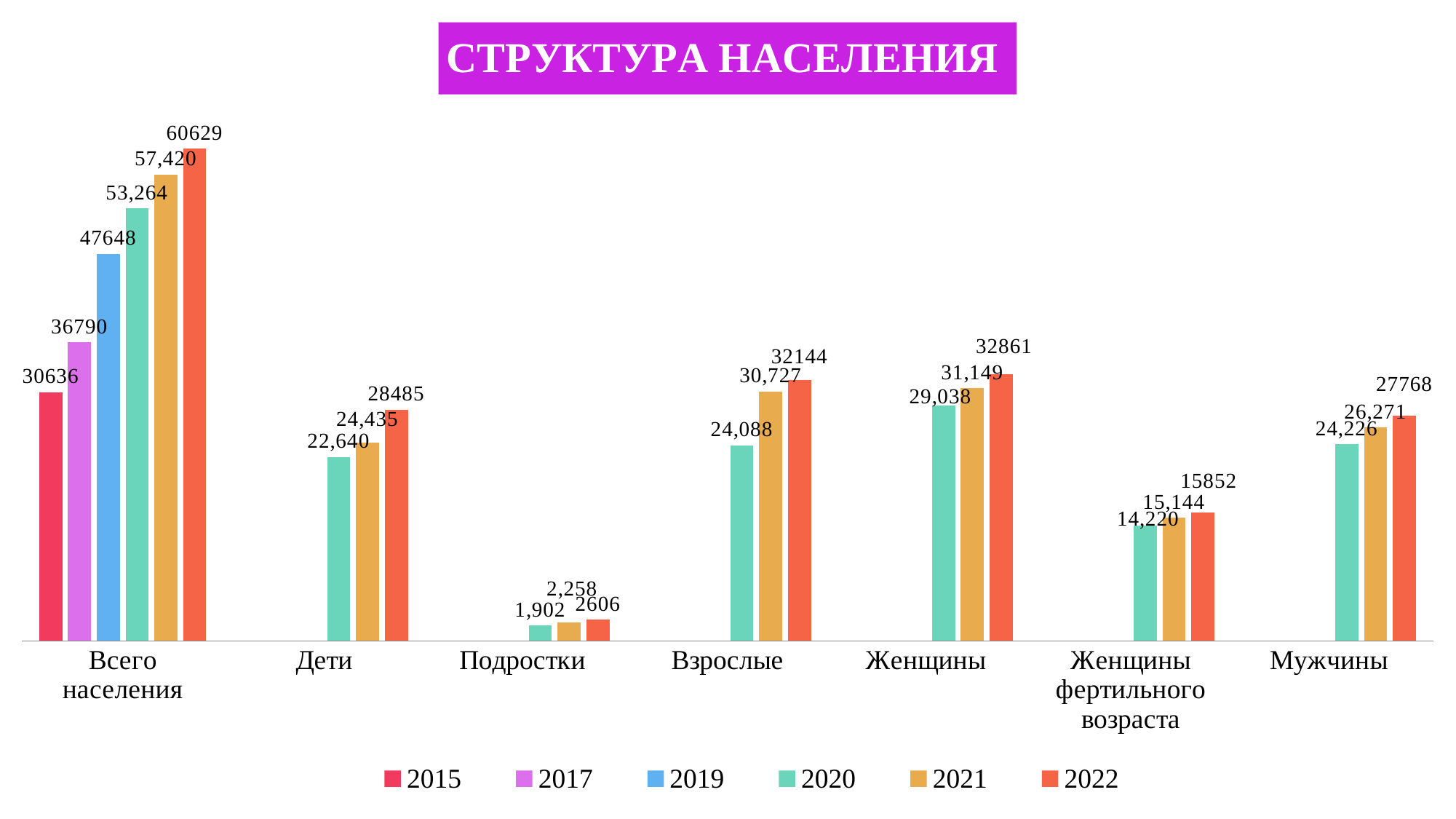
What is the difference between the 2022 and 2015 values for Всего населения? 29993 Which is larger in 2022: Женщины or Мужчины? Женщины What is the value for Подростки in 2020? 1,902 How many series does the legend list? 6 What is the value for Дети in 2021? 24,435 Do the values for Взрослые rise or fall from 2020 to 2022? Rise What is the value for Женщины фертильного возраста in 2022? 15852 What is the difference between the 2022 and 2020 values for Дети? 5845 What kind of chart is shown on the slide? Bar chart Which year has the highest value for Всего населения? 2022 What is the value for Всего населения in 2022? 60629 Which category has the lowest value in 2022? Подростки